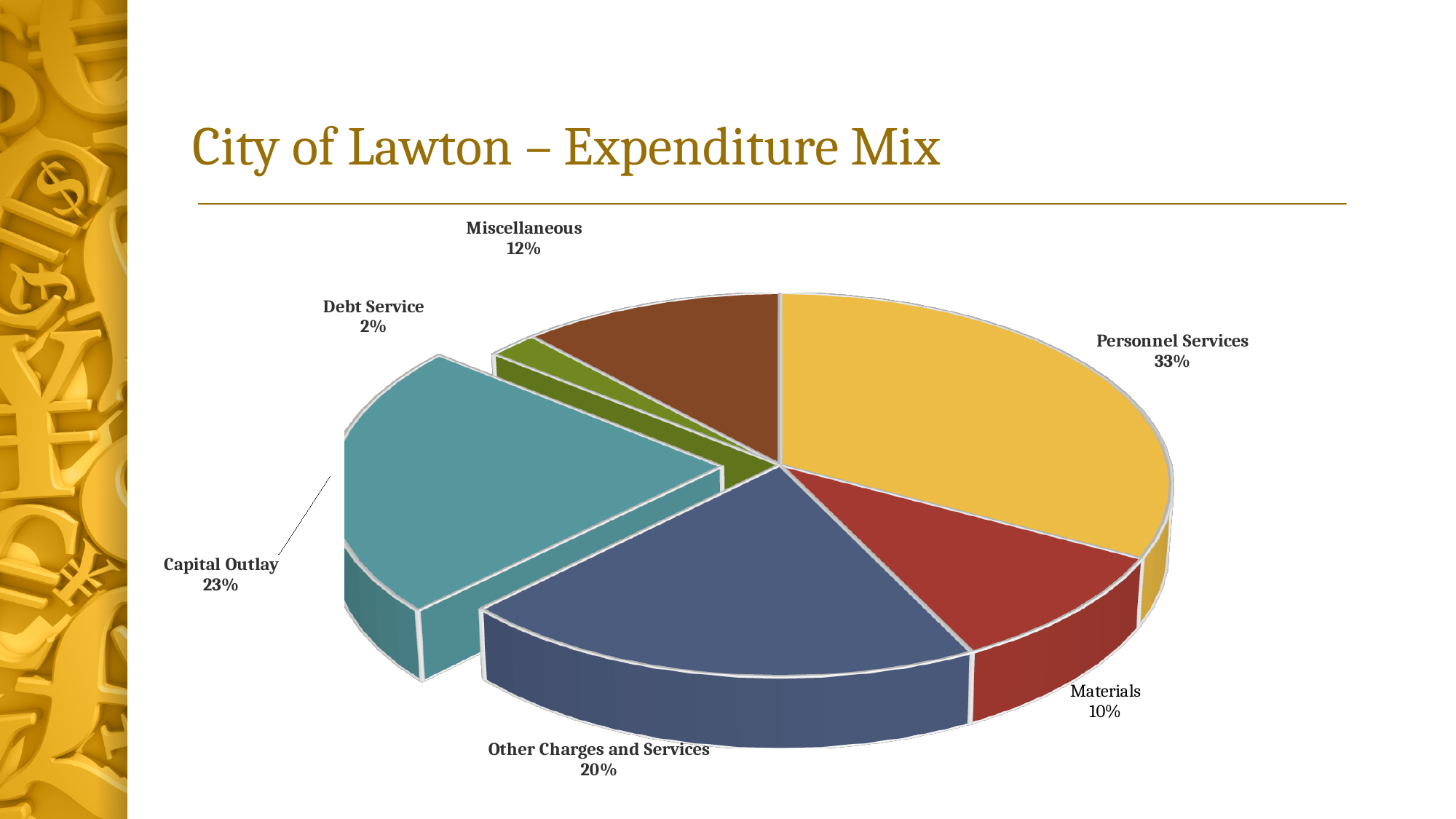
What share of expenditure is Miscellaneous? 12% What is the title of the slide? City of Lawton – Expenditure Mix What share of expenditure is Personnel Services? 33% What share of expenditure is Other Charges and Services? 20% Which category has the smallest share of expenditure? Debt Service What is the difference in percentage points between Personnel Services and Materials? 23 Which category has the largest share of expenditure? Personnel Services What kind of chart is shown on the slide? Pie chart What share of expenditure is Debt Service? 2% How many categories are shown in the pie chart? 6 What share of expenditure is Capital Outlay? 23% Which is larger, Capital Outlay or Other Charges and Services? Capital Outlay